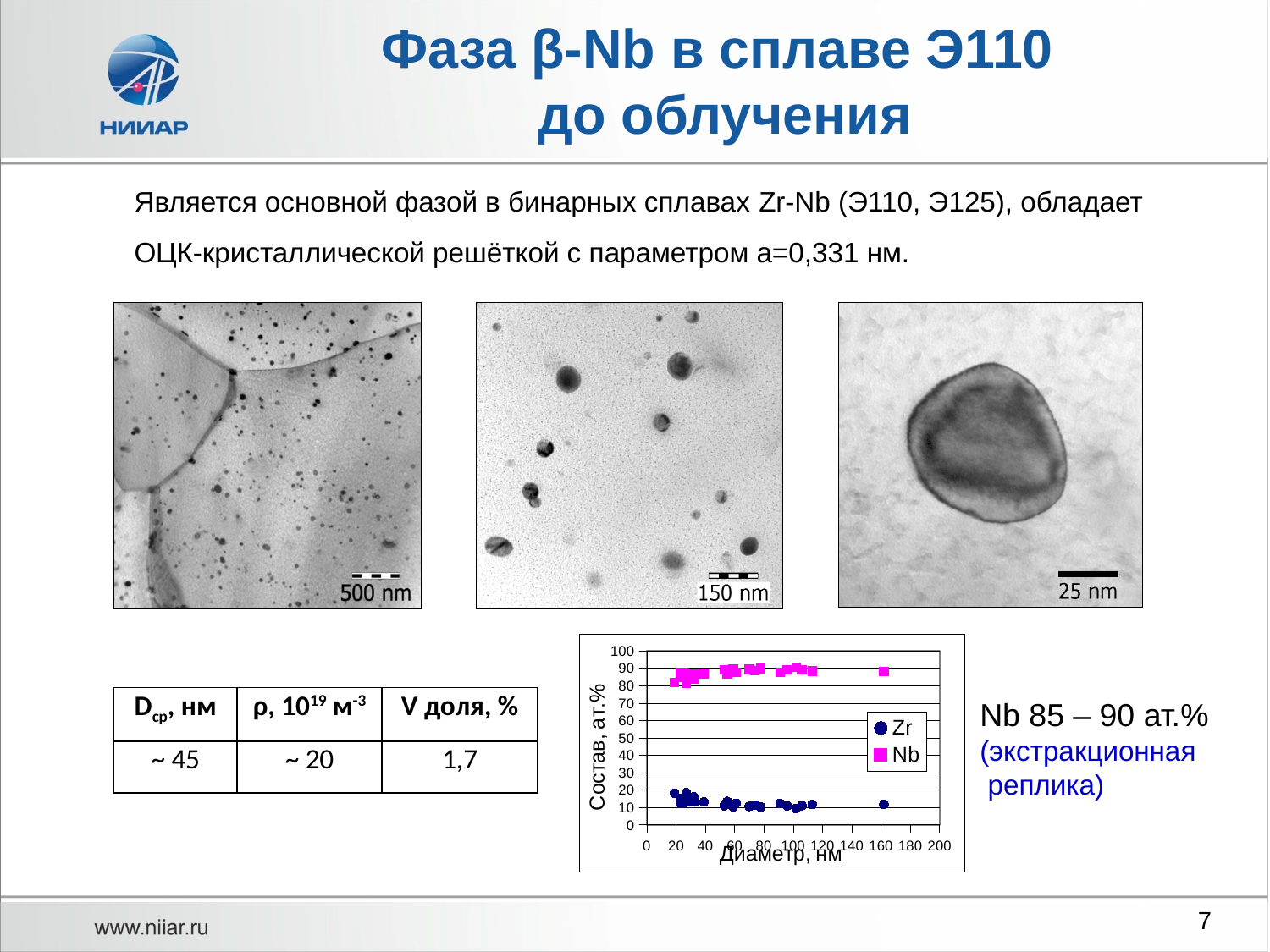
In the scatter chart, which series has the higher values: Zr or Nb? Nb What is the maximum value shown on the y axis of the scatter chart? 100 What is the title of the x axis of the scatter chart? Диаметр, нм What kind of chart is shown at the bottom of the slide? scatter chart In the scatter chart, are the Nb values greater or less than 50? greater How many series does the legend of the scatter chart list? 2 In the scatter chart, which series is plotted with magenta squares? Nb In the scatter chart, are the Zr values greater or less than 30? less